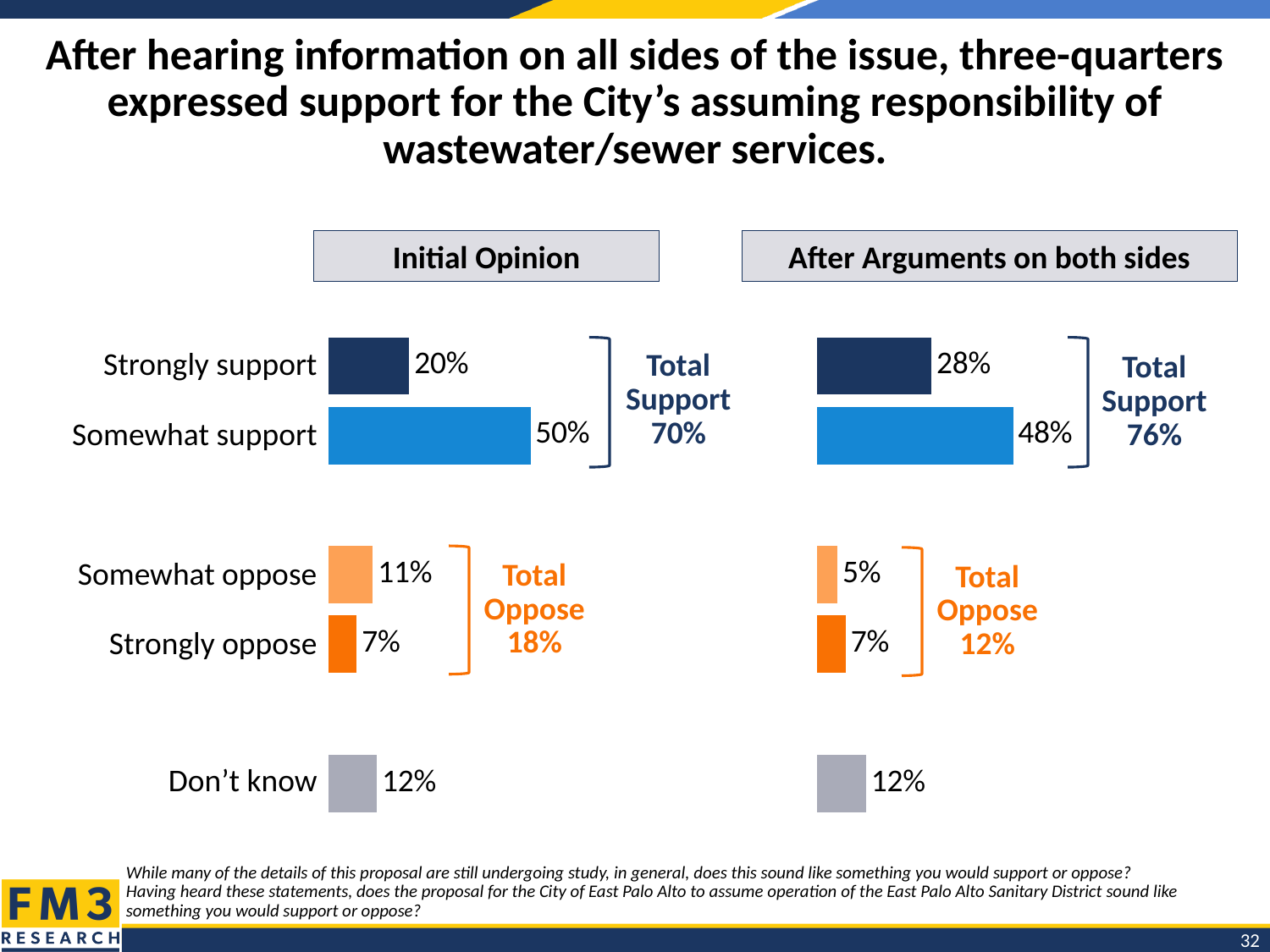
In the After Arguments on both sides chart, which category has the lowest value? Somewhat oppose In the After Arguments on both sides chart, what percentage said they don't know? 12% In the Initial Opinion chart, what percentage said they somewhat oppose? 11% How many categories are shown in the Initial Opinion chart? 5 What is the difference between the Strongly support values in the After Arguments on both sides chart and the Initial Opinion chart? 8 percentage points In the Initial Opinion chart, what percentage said they strongly support? 20% In the Initial Opinion chart, which category has the highest value? Somewhat support What is the Total Support shown for the After Arguments on both sides chart? 76% In the After Arguments on both sides chart, what percentage said they somewhat support? 48% In the Initial Opinion chart, which is larger: Somewhat oppose or Strongly oppose? Somewhat oppose What type of chart is used on this slide? Bar chart What is the Total Oppose shown for the Initial Opinion chart? 18%